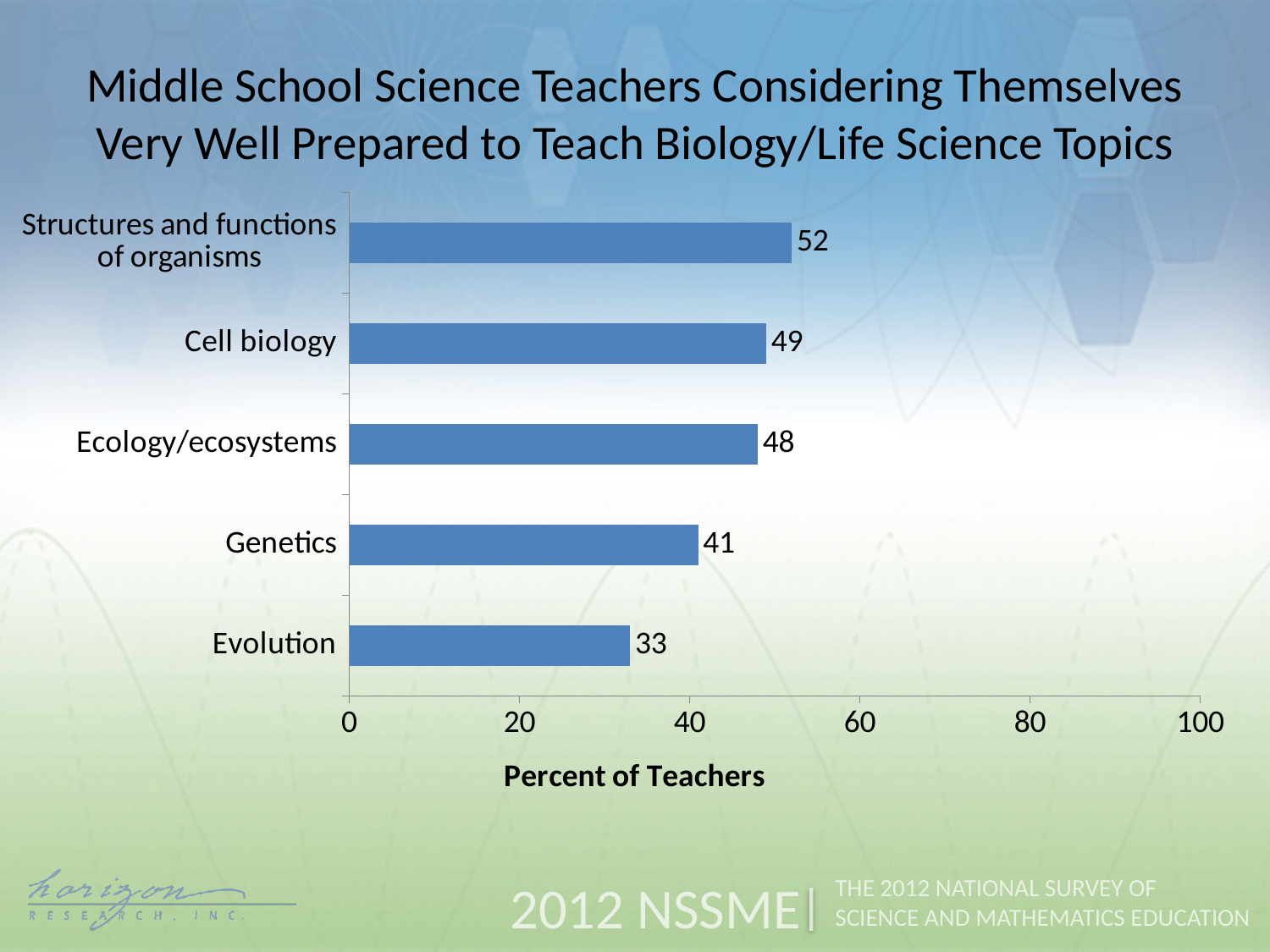
What is the difference between the values for Structures and functions of organisms and Evolution? 19 Which topic has the lowest percent of teachers considering themselves very well prepared? Evolution What is the value shown for Evolution? 33 How many topics are shown in the chart? 5 What percent of middle school science teachers consider themselves very well prepared to teach Cell biology? 49 What kind of chart is shown on the slide? Bar chart Which topic has the highest percent of teachers considering themselves very well prepared? Structures and functions of organisms What is the label of the horizontal axis? Percent of Teachers Is the value for Evolution greater or less than 40? less Which has a larger value, Genetics or Ecology/ecosystems? Ecology/ecosystems What is the difference between the values for Cell biology and Genetics? 8 What is the value shown for Genetics? 41